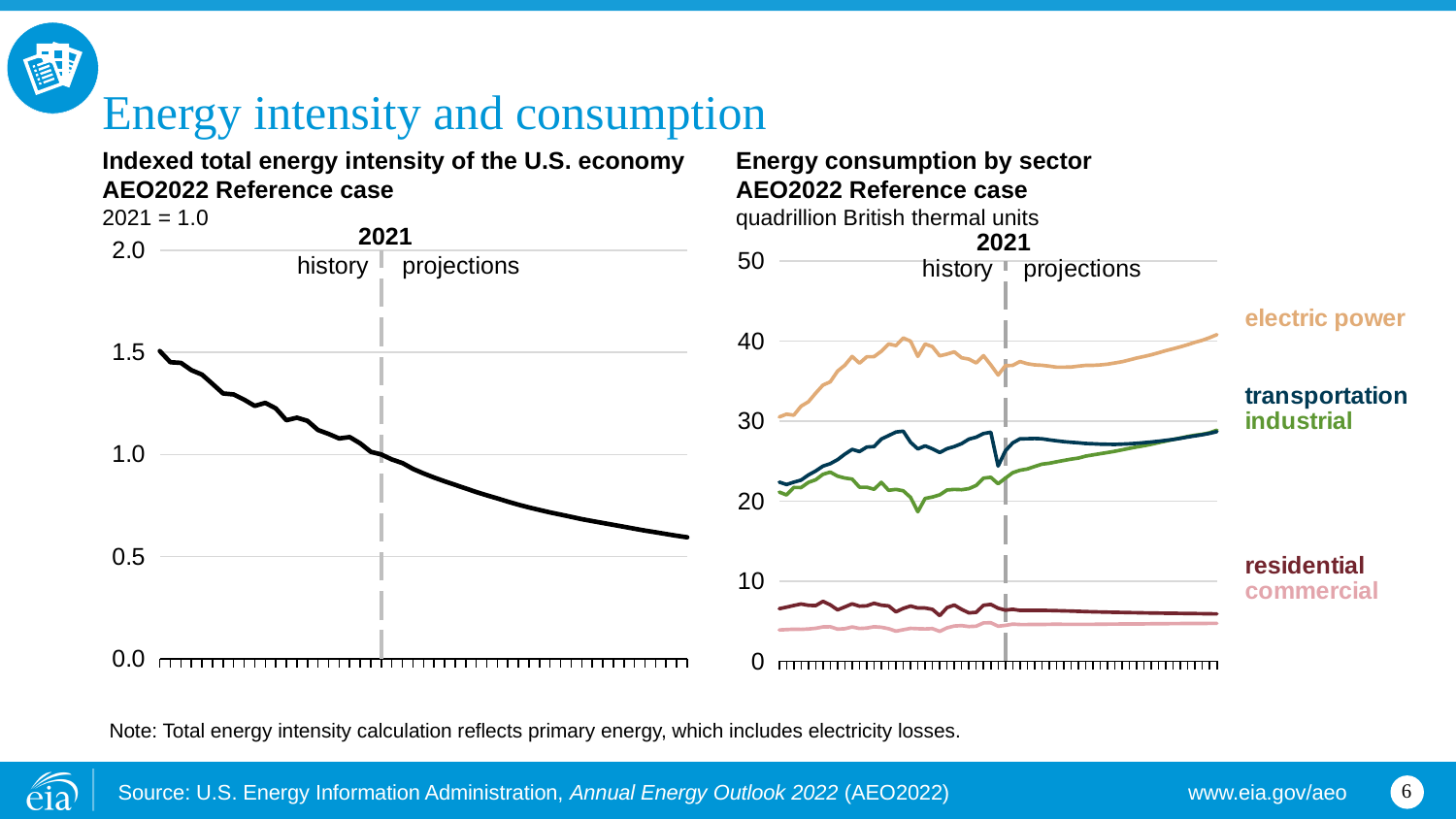
How many sectors are plotted in the 'Energy consumption by sector' chart? 5 What unit is used on the y axis of the 'Energy consumption by sector' chart? quadrillion British thermal units In the 'Indexed total energy intensity of the U.S. economy' chart, does the index rise or fall over time along the x axis? fall What kind of chart is the 'Indexed total energy intensity of the U.S. economy' chart on the left? line chart In the 'Energy consumption by sector' chart, is the residential sector's consumption greater or less than 10 quadrillion British thermal units? less In the 'Indexed total energy intensity of the U.S. economy' chart, is the index value at the end of the projection period greater or less than 0.5? greater In the 'Energy consumption by sector' chart, which sector has the lowest energy consumption? commercial In the 'Energy consumption by sector' chart, which is larger in 2021: electric power or industrial consumption? electric power In the 'Energy consumption by sector' chart, which sector has the highest energy consumption? electric power In the 'Indexed total energy intensity of the U.S. economy' chart, what is the index value in 2021? 1.0 What kind of chart is the 'Energy consumption by sector' chart on the right? line chart In the 'Indexed total energy intensity of the U.S. economy' chart, is the index value at the end of the projection period greater or less than 1.0? less